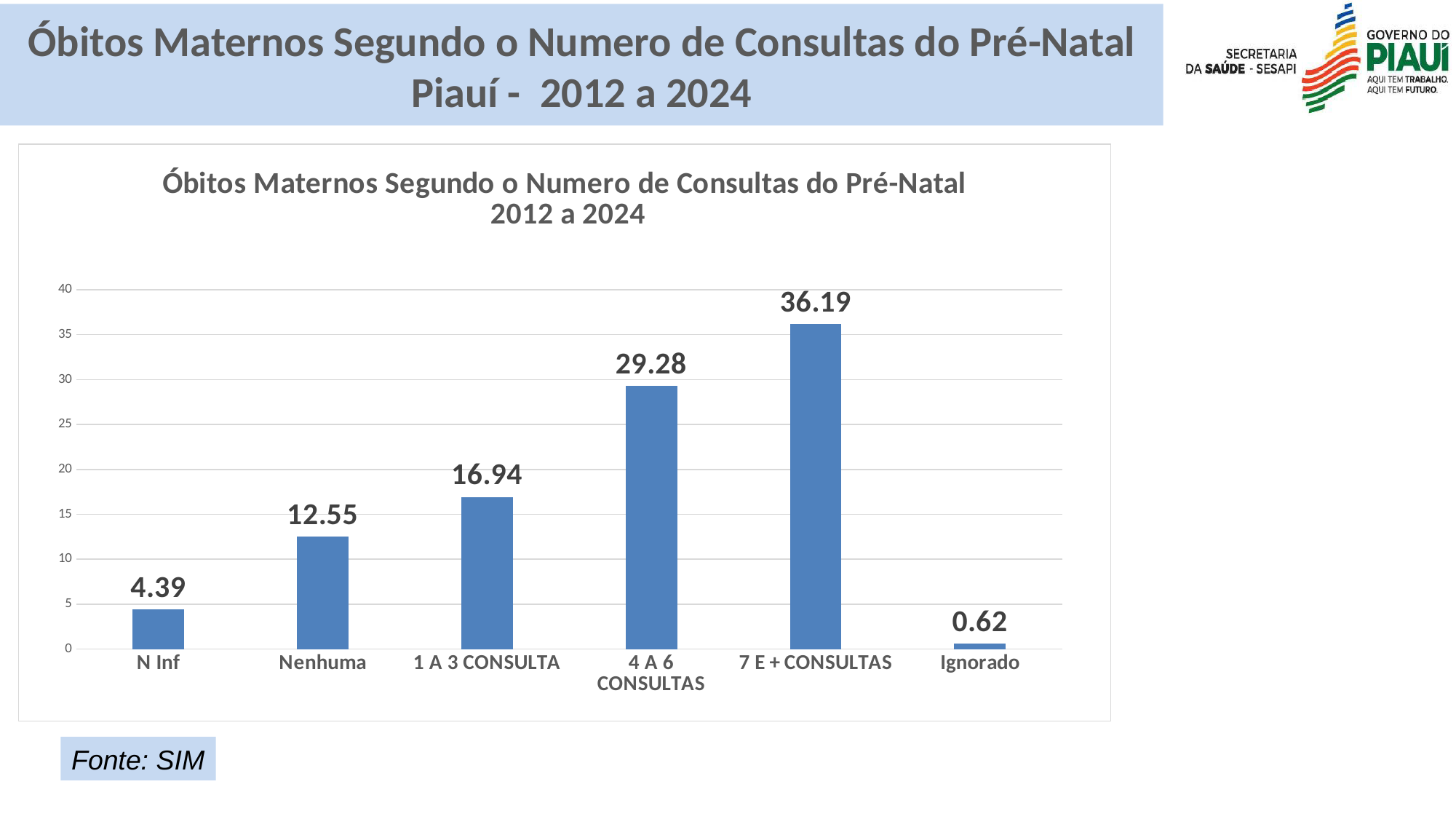
Which category has the highest value? 7 E + CONSULTAS What is the value for 1 A 3 CONSULTA? 16.94 What kind of chart is shown on the slide? bar chart How many categories are shown on the x axis? 6 What is the value for 7 E + CONSULTAS? 36.19 What is the title of the chart? Óbitos Maternos Segundo o Numero de Consultas do Pré-Natal 2012 a 2024 What is the value for Nenhuma? 12.55 Which category has the lowest value? Ignorado Is the value for 4 A 6 CONSULTAS greater or less than 25? greater Which is larger, the value for Nenhuma or the value for 1 A 3 CONSULTA? 1 A 3 CONSULTA What is the difference between the values for 7 E + CONSULTAS and 4 A 6 CONSULTAS? 6.91 What is the value for N Inf? 4.39